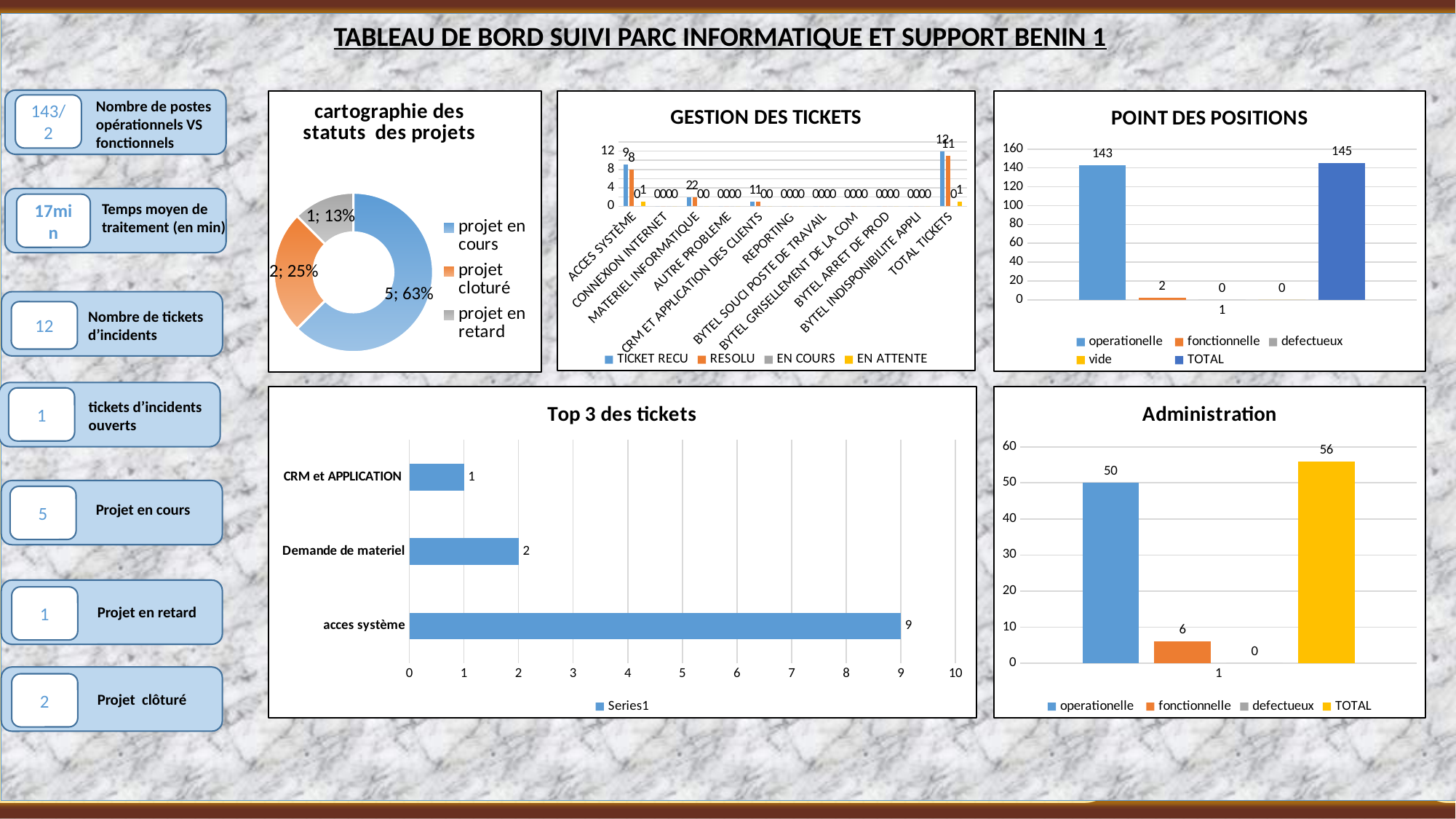
In the 'Administration' chart, which series has the highest value? TOTAL In the 'Administration' chart, what is the difference between TOTAL and operationelle? 6 In the 'Top 3 des tickets' chart, what is the value for acces système? 9 In the 'GESTION DES TICKETS' chart, what is the TICKET RECU value for TOTAL TICKETS? 12 In the 'Top 3 des tickets' chart, which category has the lowest value? CRM et APPLICATION In the 'Administration' chart, what is the value for fonctionnelle? 6 In the 'cartographie des statuts des projets' chart, what is the value for 'projet en retard'? 1 What kind of chart is 'Top 3 des tickets'? bar chart In the 'POINT DES POSITIONS' chart, what is the value for operationelle? 143 In the 'cartographie des statuts des projets' chart, what share does 'projet en cours' have? 63% In the 'Top 3 des tickets' chart, what is the difference between acces système and Demande de materiel? 7 In the 'POINT DES POSITIONS' chart, how many series does the legend list? 5